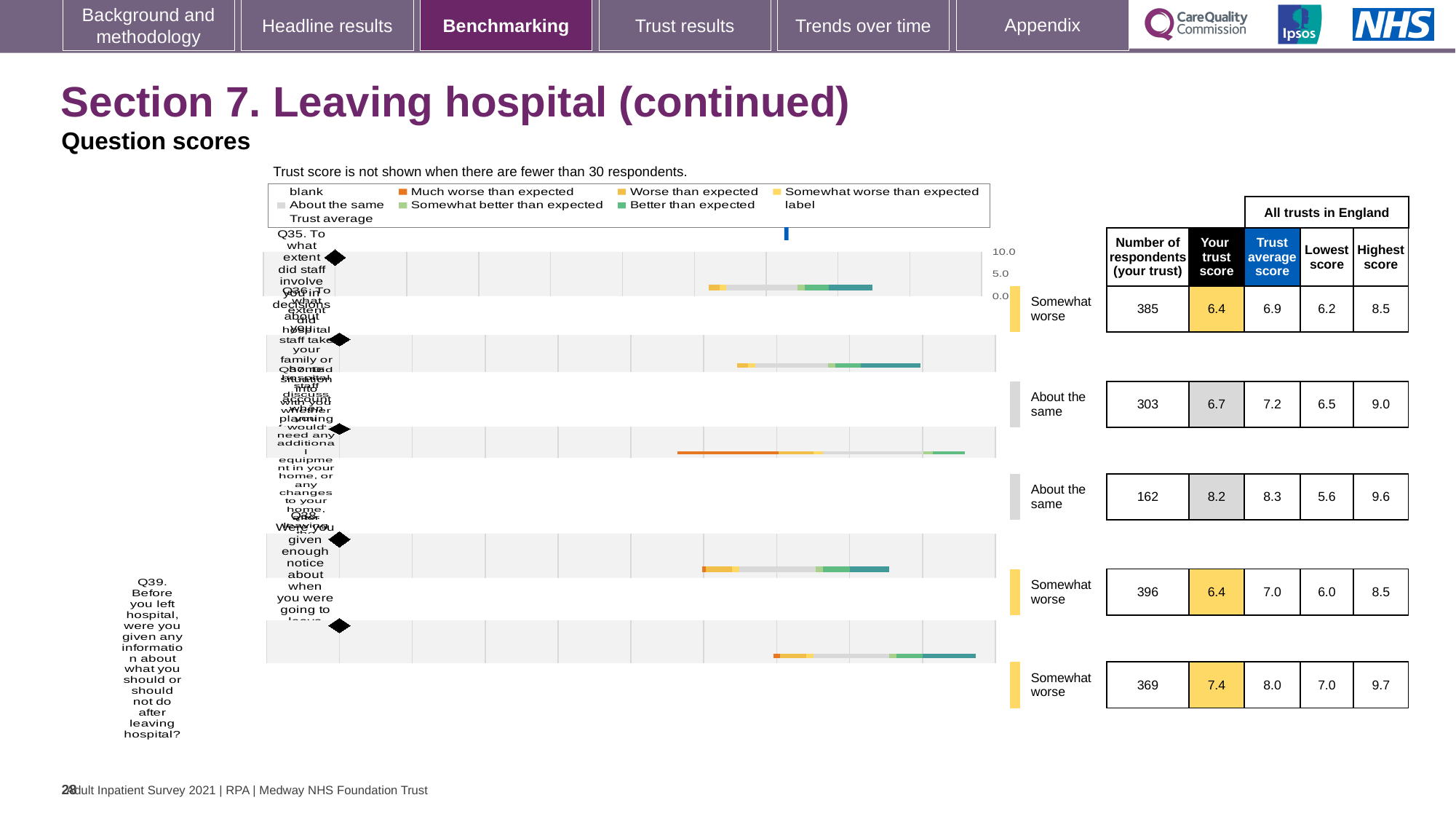
How many respondents answered Q36 (did hospital staff take your family or home situation into account)? 303 What is the trust score for Q35 (to what extent did staff involve you in decisions about leaving hospital)? 6.4 What benchmark category is shown for Q38 (were you given enough notice about when you were going to leave hospital)? Somewhat worse How many questions (rows) are plotted in the chart? 5 Which question has the highest 'Your trust score' value? Q37 (third row), 8.2 Which question has the highest number of respondents? Q38, 396 What is the trust average score for Q39 (information about what you should or should not do after leaving hospital)? 8.0 Which question has the lowest 'Lowest score' value across all trusts in England? Q37 (third row), 5.6 Is the trust score for Q35 greater or less than 5.0? greater What is the difference between the trust average score and your trust score for Q39? 0.6 What kind of chart is shown on the slide? bar chart For Q36, which is larger: your trust score or the trust average score? Trust average score (7.2)